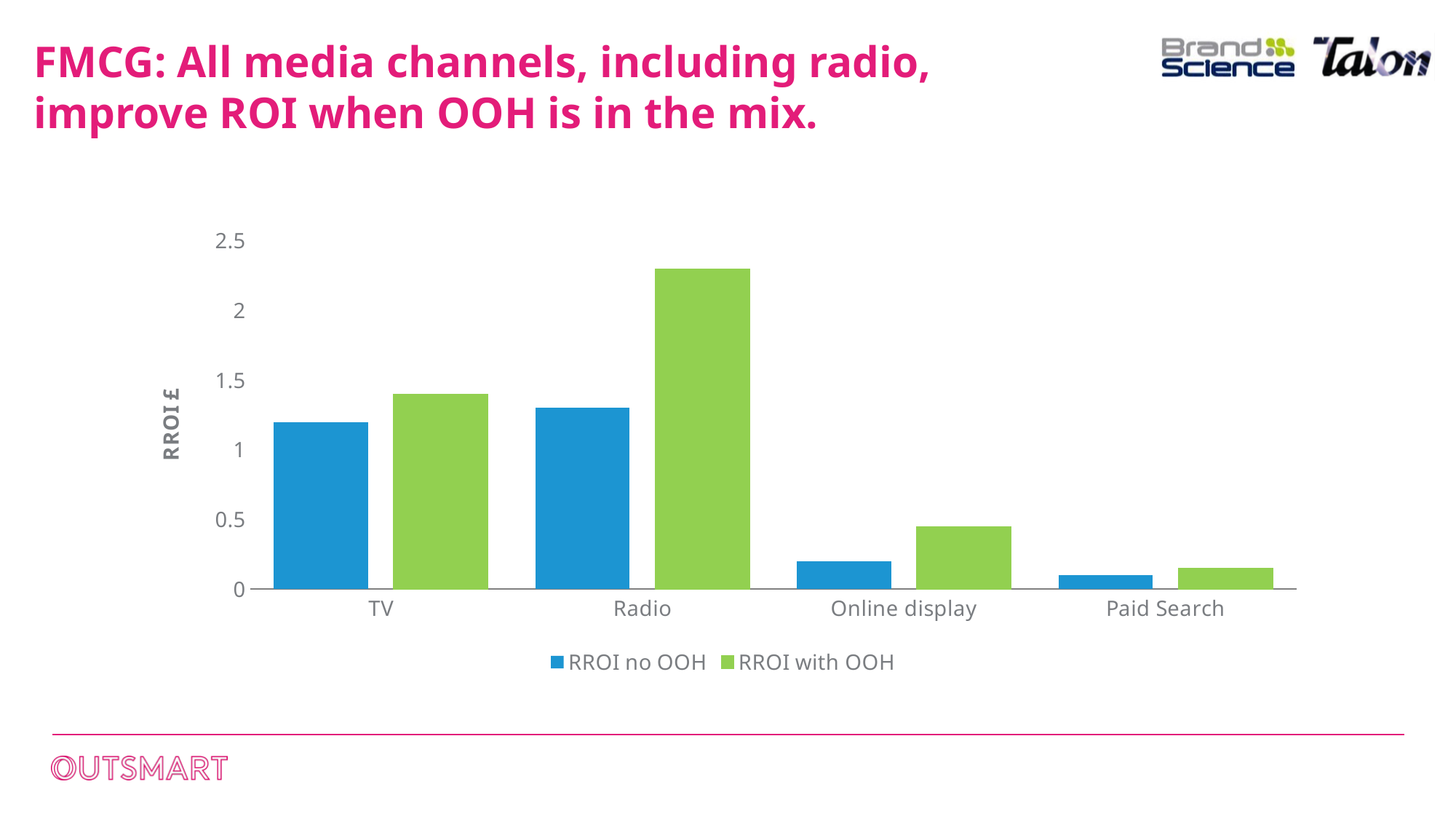
How many media channels are shown on the x axis of the chart? 4 Is the RROI with OOH value for Online display greater or less than 0.5? less Which media channel has the lowest RROI no OOH? Paid Search Which is larger: the RROI with OOH for TV or the RROI with OOH for Online display? TV Is the RROI no OOH value for TV greater or less than 1? greater What is the label on the chart's vertical axis? RROI £ How many series does the chart's legend list? 2 Is the RROI no OOH value for Paid Search greater or less than 0.5? less For Radio, which is larger: RROI no OOH or RROI with OOH? RROI with OOH Which media channel has the highest RROI with OOH? Radio What kind of chart is shown on the slide? bar chart